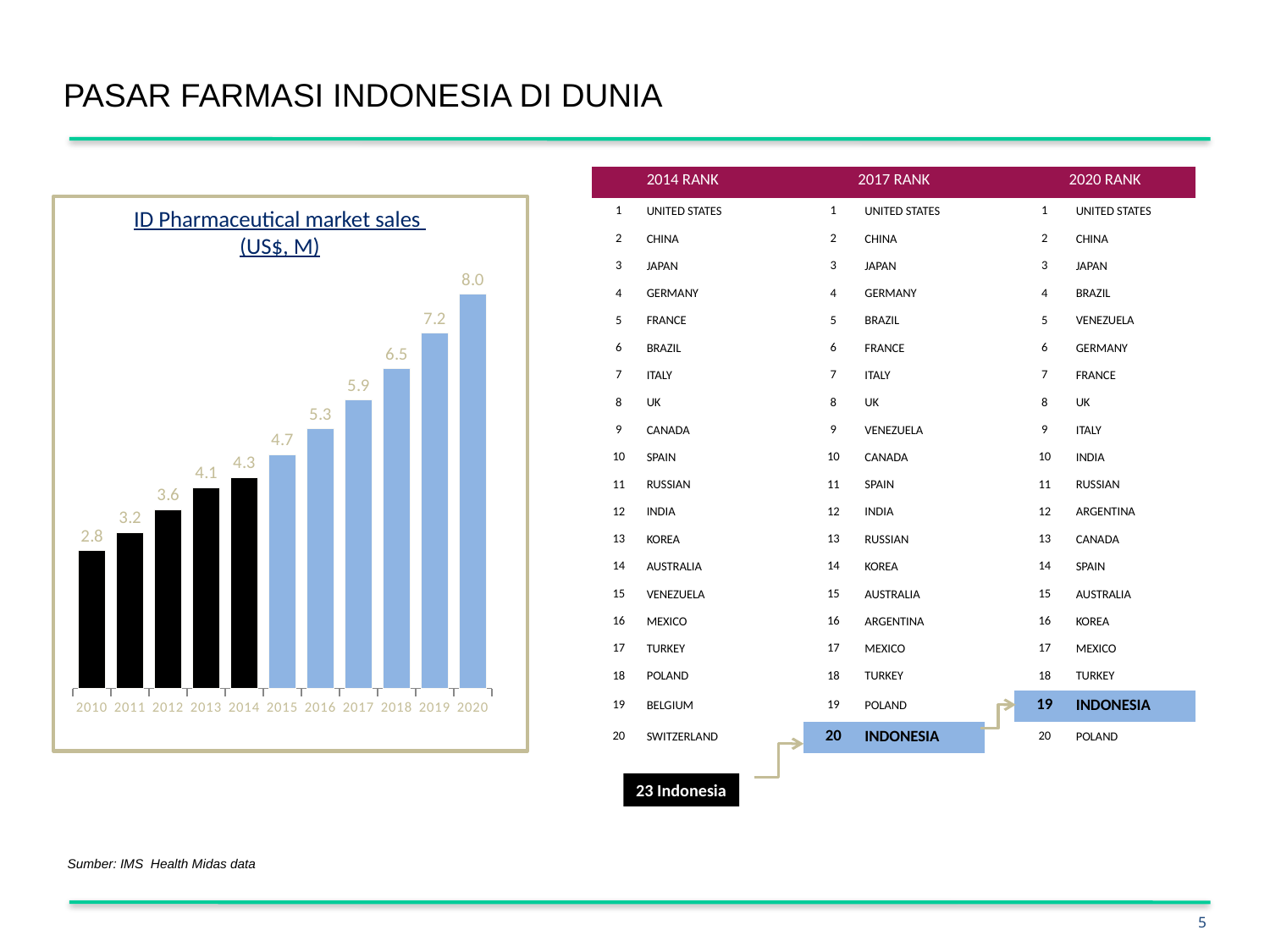
Do the ID Pharmaceutical market sales values rise or fall from 2010 to 2020? rise How many years are shown on the x axis of the ID Pharmaceutical market sales chart? 11 Which year has the lowest ID Pharmaceutical market sales value? 2010 What is the difference between the ID Pharmaceutical market sales values for 2017 and 2016? 0.6 What unit is given in the title of the ID Pharmaceutical market sales chart? US$, M What is the ID Pharmaceutical market sales value for 2020? 8.0 Which year has the highest ID Pharmaceutical market sales value? 2020 What is the difference between the ID Pharmaceutical market sales values for 2020 and 2010? 5.2 Which is larger, the ID Pharmaceutical market sales value for 2016 or for 2013? 2016 What is the ID Pharmaceutical market sales value for 2010? 2.8 What kind of chart is the ID Pharmaceutical market sales chart? bar chart What is the ID Pharmaceutical market sales value for 2014? 4.3